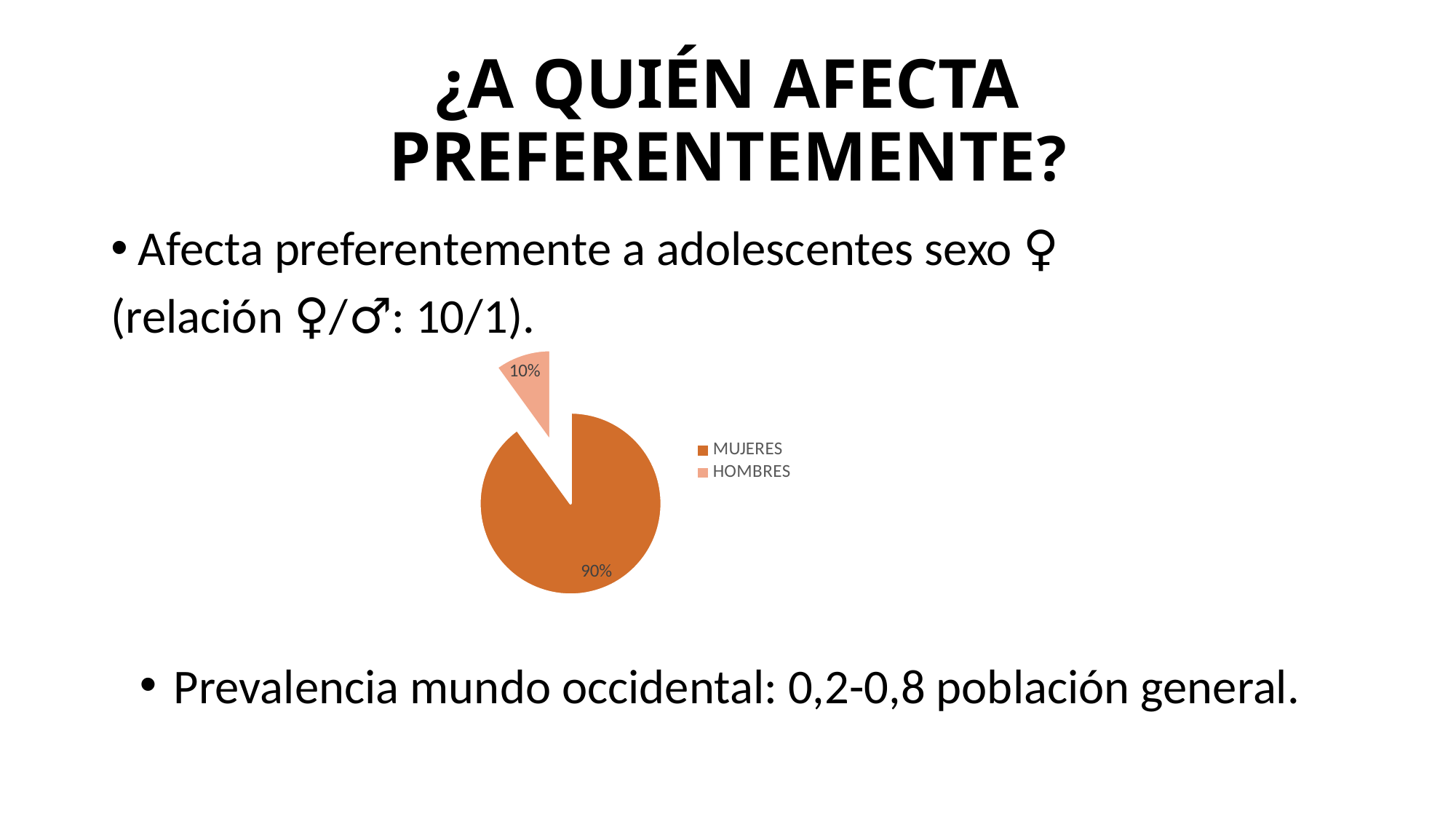
How many entries does the legend list? 2 Which legend entry is shown in the lighter orange colour? HOMBRES Which category has the smallest slice of the pie? HOMBRES Which slice of the pie is pulled out (exploded) from the rest? HOMBRES How many categories does the pie chart show? 2 What share of the pie does MUJERES represent? 90% What kind of chart is shown on the slide? pie chart Which slice is larger, MUJERES or HOMBRES? MUJERES What is the difference in percentage points between the MUJERES and HOMBRES slices? 80 Which category has the largest slice of the pie? MUJERES What share of the pie does HOMBRES represent? 10%